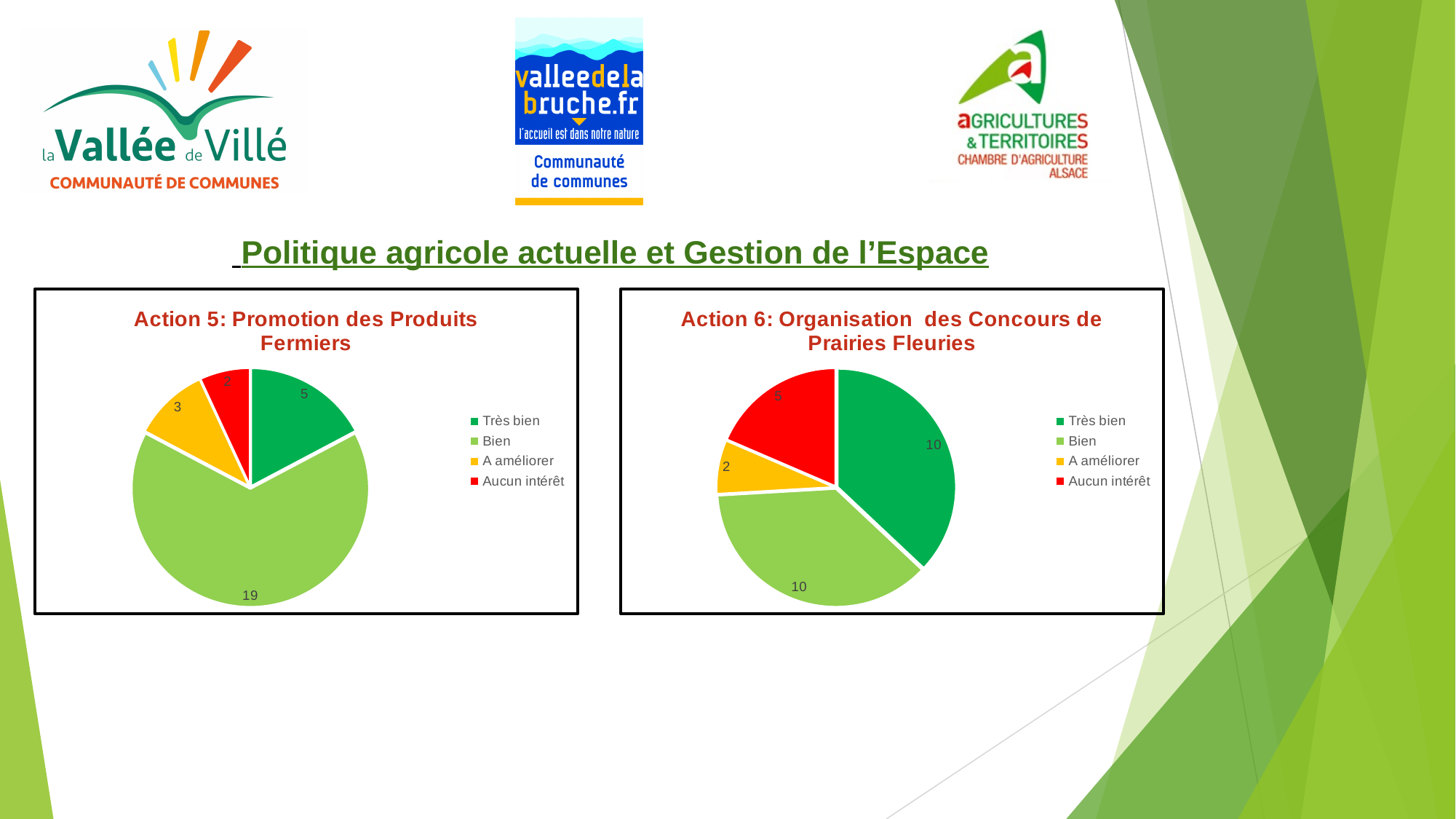
In the 'Action 5: Promotion des Produits Fermiers' chart, what is the value for 'Aucun intérêt'? 2 In the 'Action 6: Organisation des Concours de Prairies Fleuries' chart, which is larger, 'Aucun intérêt' or 'A améliorer'? Aucun intérêt In the 'Action 6: Organisation des Concours de Prairies Fleuries' chart, which category has the smallest slice? A améliorer In the 'Action 6: Organisation des Concours de Prairies Fleuries' chart, what is the value for 'A améliorer'? 2 In the 'Action 5: Promotion des Produits Fermiers' chart, what colour is the 'A améliorer' slice? Yellow In the 'Action 6: Organisation des Concours de Prairies Fleuries' chart, what is the value for 'Aucun intérêt'? 5 In the 'Action 5: Promotion des Produits Fermiers' chart, which category has the smallest slice? Aucun intérêt How many categories does the legend of the 'Action 6: Organisation des Concours de Prairies Fleuries' chart list? 4 What type of chart is 'Action 5: Promotion des Produits Fermiers'? Pie chart In the 'Action 5: Promotion des Produits Fermiers' chart, what is the difference between the values for 'Bien' and 'Très bien'? 14 In the 'Action 5: Promotion des Produits Fermiers' chart, what is the value for 'Bien'? 19 In the 'Action 5: Promotion des Produits Fermiers' chart, which category has the largest slice? Bien